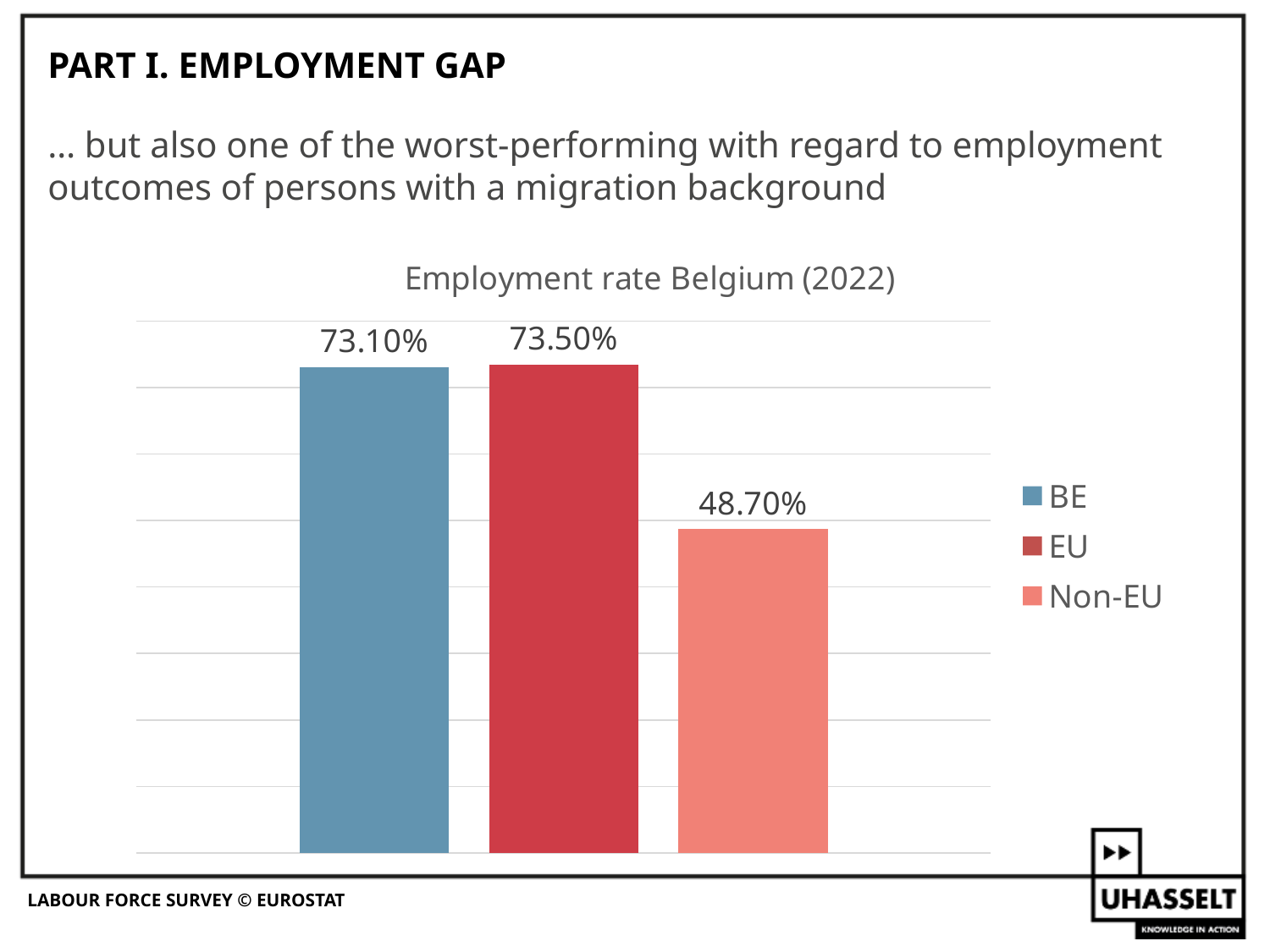
What kind of chart is shown on the slide? Bar chart What is the employment rate shown for EU? 73.50% What is the title of the chart? Employment rate Belgium (2022) Which is larger, the employment rate for BE or for Non-EU? BE How many entries does the legend list? 3 What is the difference between the EU and Non-EU employment rates? 24.80% What is the employment rate shown for BE? 73.10% Which group has the highest employment rate in the chart? EU How many bars are plotted in the chart? 3 What is the difference between the BE and Non-EU employment rates? 24.40% Which group has the lowest employment rate in the chart? Non-EU What is the employment rate shown for Non-EU? 48.70%